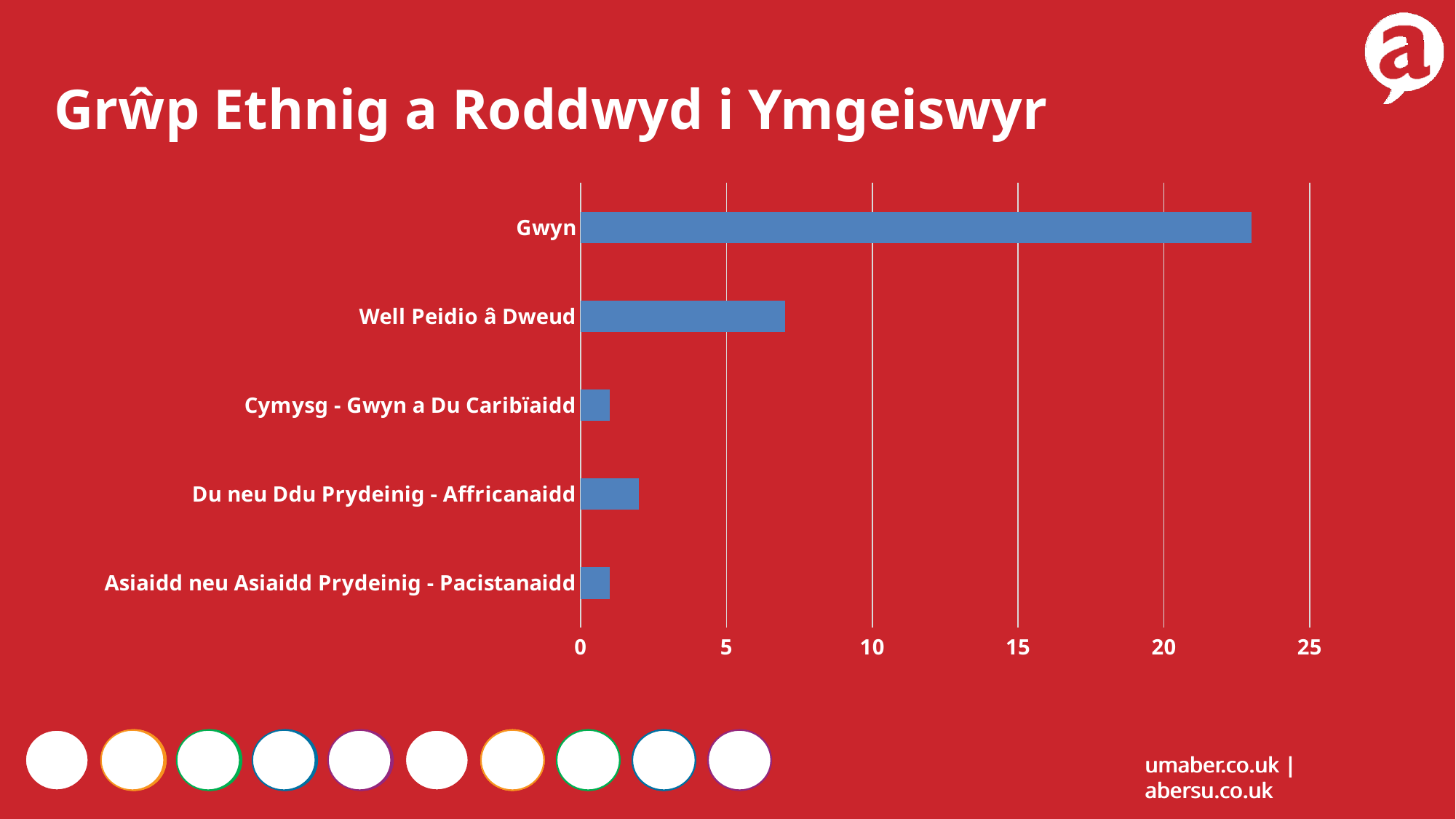
What kind of chart is shown on the slide? bar chart How many categories are plotted in the chart? 5 Is the value for Du neu Ddu Prydeinig - Affricanaidd greater or less than 5? less Is the value for Well Peidio â Dweud greater or less than 5? greater Is the value for Well Peidio â Dweud greater or less than 10? less Which is larger, the value for Du neu Ddu Prydeinig - Affricanaidd or the value for Cymysg - Gwyn a Du Caribïaidd? Du neu Ddu Prydeinig - Affricanaidd What is the title of the chart on the slide? Grŵp Ethnig a Roddwyd i Ymgeiswyr What is the highest value shown on the horizontal axis? 25 Which is larger, the value for Gwyn or the value for Well Peidio â Dweud? Gwyn Which category has the highest value? Gwyn